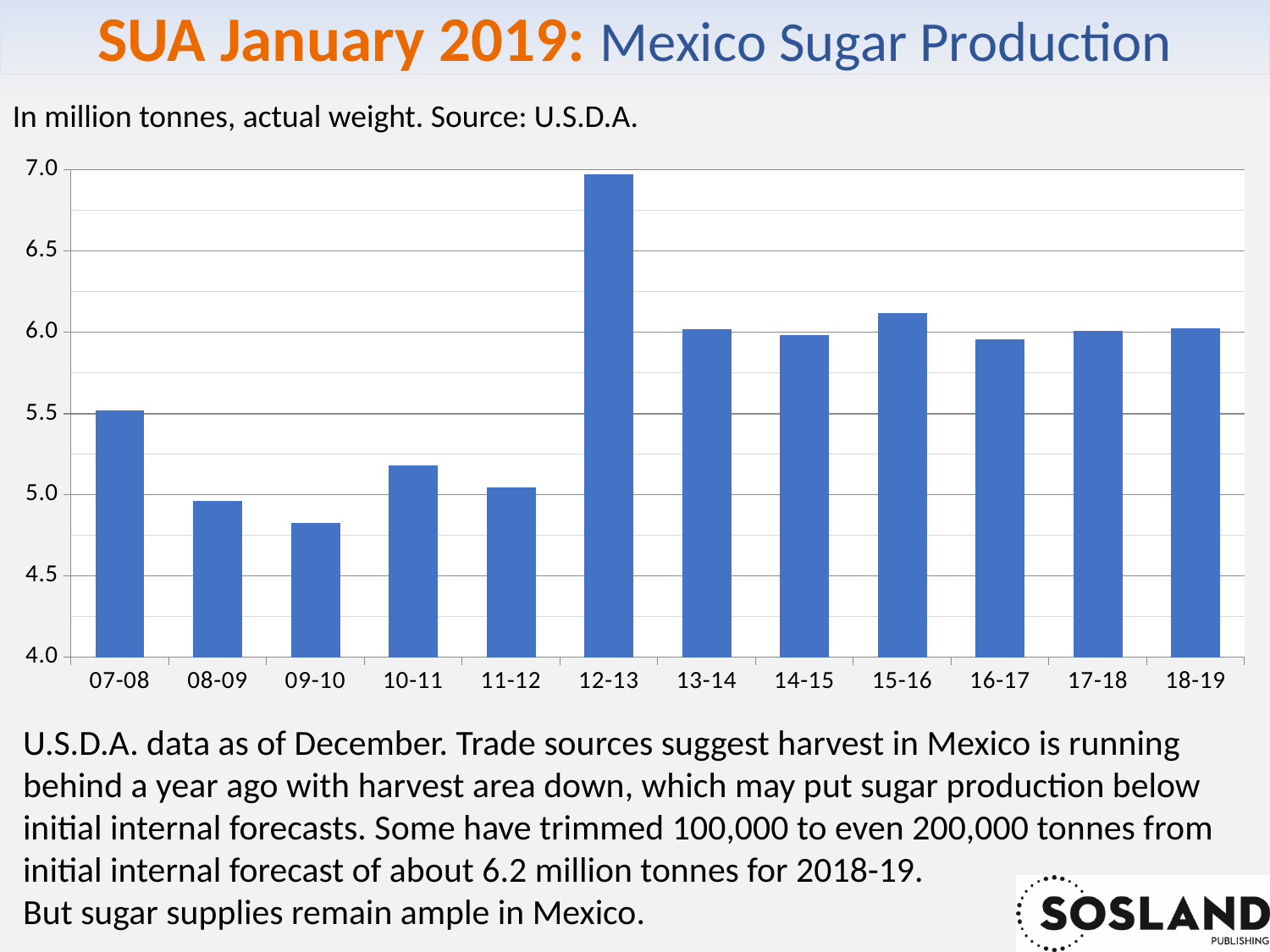
Which is larger, the value for 07-08 or the value for 10-11? 07-08 Which crop year has the lowest Mexico sugar production in the chart? 09-10 Is the value for 12-13 greater or less than 6.5? greater In what units is Mexico sugar production shown on the chart? million tonnes, actual weight How many crop years are shown on the x axis of the chart? 12 Do the values rise or fall from 07-08 to 09-10? fall Is the value for 11-12 greater or less than 5.5? less Is the value for 09-10 greater or less than 5.0? less What kind of chart is shown on the slide? bar chart Which crop year has the highest Mexico sugar production in the chart? 12-13